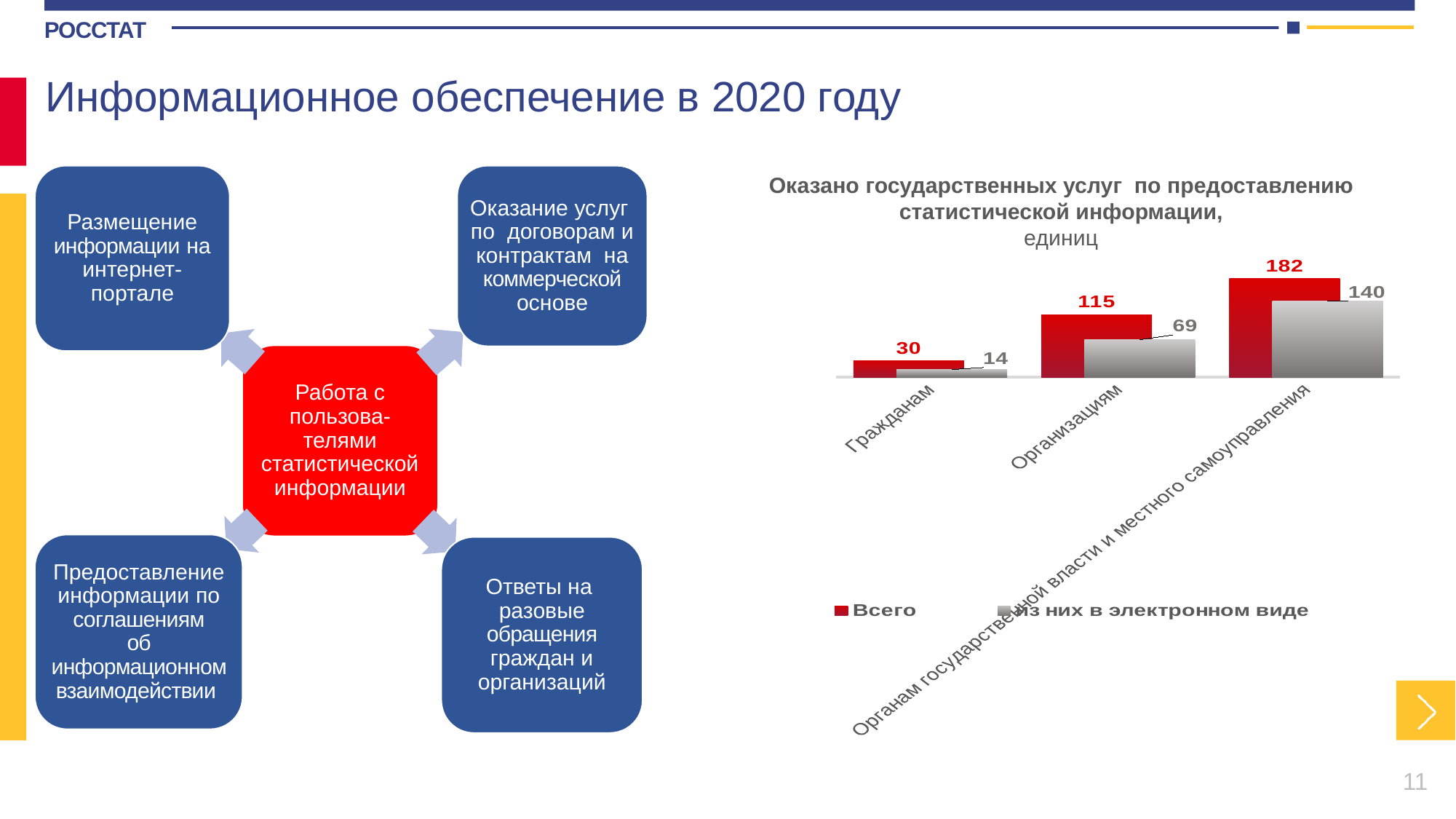
How many series does the legend list? 2 Which is larger: "из них в электронном виде" for "Органам государственной власти и местного самоуправления" or "Всего" for "Организациям"? из них в электронном виде for Органам государственной власти и местного самоуправления What is the value of "Всего" for "Органам государственной власти и местного самоуправления"? 182 How many categories are shown on the chart? 3 What type of chart is shown on the slide? Bar chart What is the value of "из них в электронном виде" for "Гражданам"? 14 What is the value of "из них в электронном виде" for "Организациям"? 69 Which category has the lowest "из них в электронном виде" value? Гражданам What is the difference between "Всего" and "из них в электронном виде" for "Организациям"? 46 Which category has the highest "Всего" value? Органам государственной власти и местного самоуправления What is the value of "Всего" for "Гражданам"? 30 What is the difference between the "Всего" values for "Органам государственной власти и местного самоуправления" and "Организациям"? 67